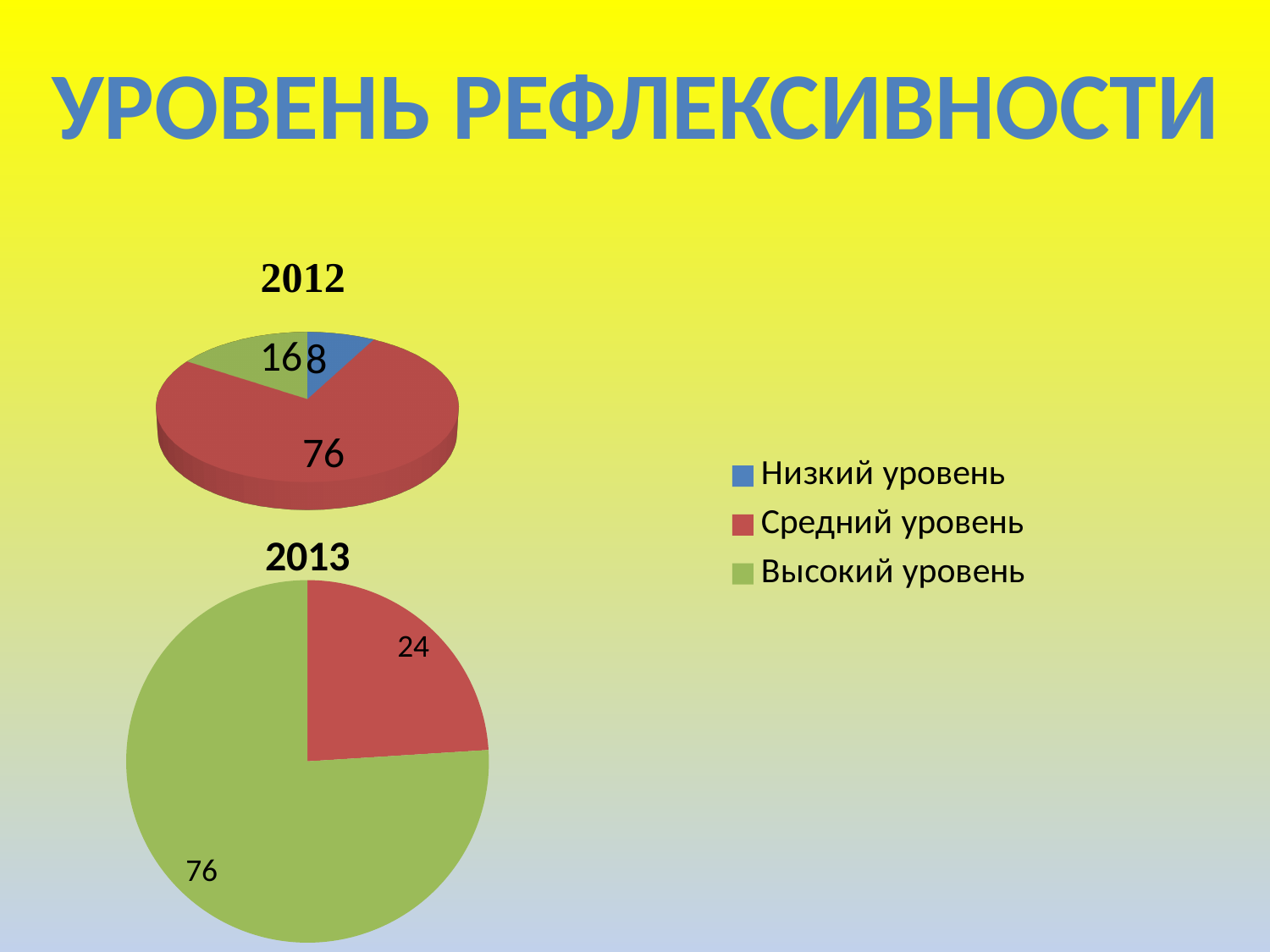
In the 2013 chart, what is the value for Средний уровень? 24 In the 2013 chart, what is the value for Высокий уровень? 76 In the 2013 chart, which category has the largest slice? Высокий уровень In the 2012 chart, what is the value for Низкий уровень? 8 In the 2012 chart, which category has the smallest slice? Низкий уровень In the 2012 chart, what is the value for Средний уровень? 76 In the 2012 chart, which category has the largest slice? Средний уровень In the 2012 chart, what is the value for Высокий уровень? 16 How many entries does the legend list? 3 What kind of chart is the 2013 chart? Pie chart In the 2013 chart, what is the difference between Высокий уровень and Средний уровень? 52 In the 2012 chart, which is larger, Высокий уровень or Низкий уровень? Высокий уровень